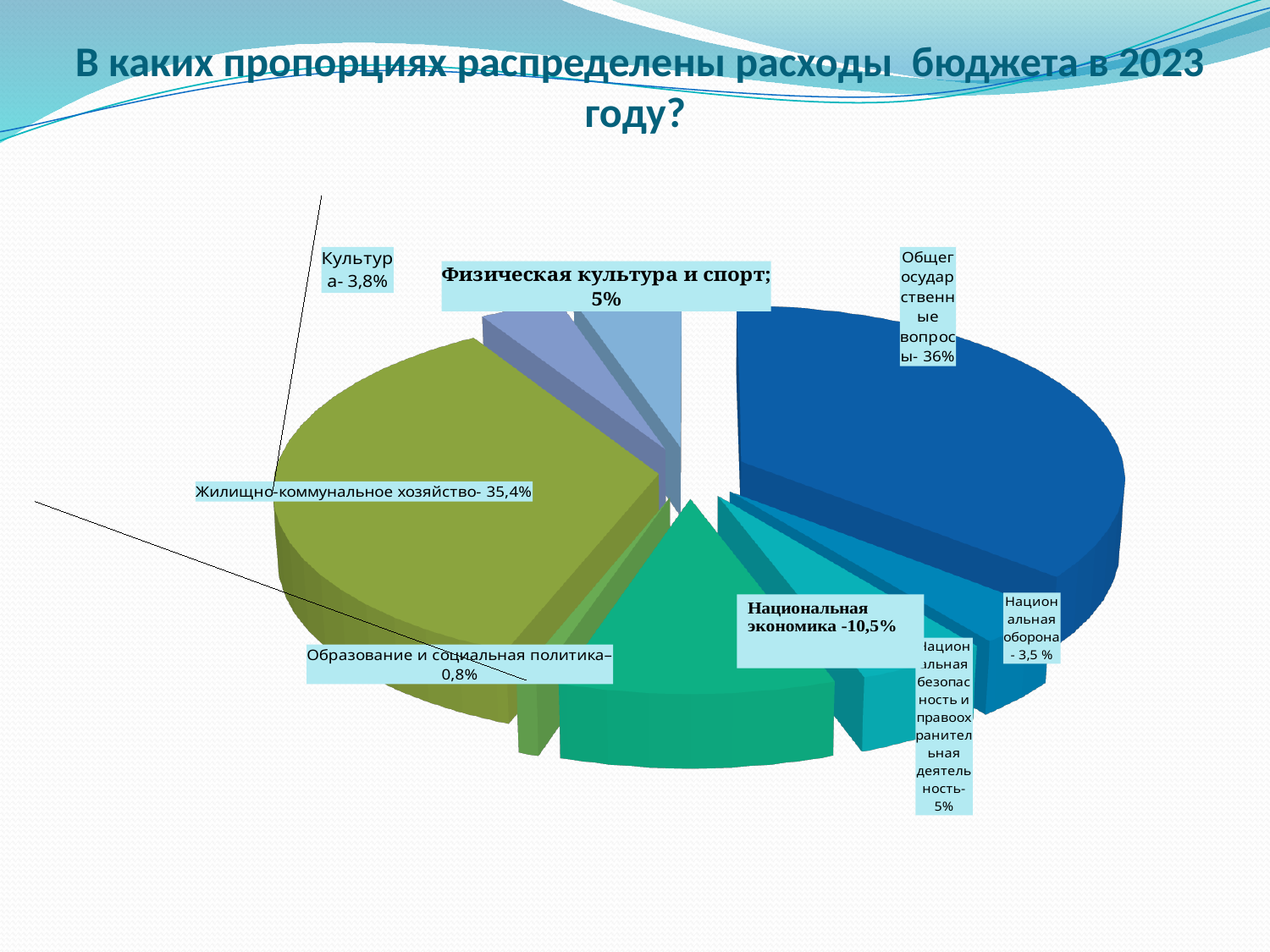
Which category has the largest share of the 2023 budget expenditure? Общегосударственные вопросы What share of the 2023 budget expenditure goes to Национальная экономика? 10,5% What is the difference in percentage points between the shares for Общегосударственные вопросы and Национальная экономика? 25,5 What kind of chart is shown on the slide? pie chart Which is larger: the share for Национальная экономика or the share for Физическая культура и спорт? Национальная экономика What share of the 2023 budget expenditure goes to Национальная оборона? 3,5 % How many categories are shown in the pie chart? 8 Which category has the smallest share of the 2023 budget expenditure? Образование и социальная политика What share of the 2023 budget expenditure goes to Образование и социальная политика? 0,8% What share of the 2023 budget expenditure goes to Жилищно-коммунальное хозяйство? 35,4% What share of the 2023 budget expenditure goes to Культура? 3,8% What share of the 2023 budget expenditure goes to Общегосударственные вопросы? 36%